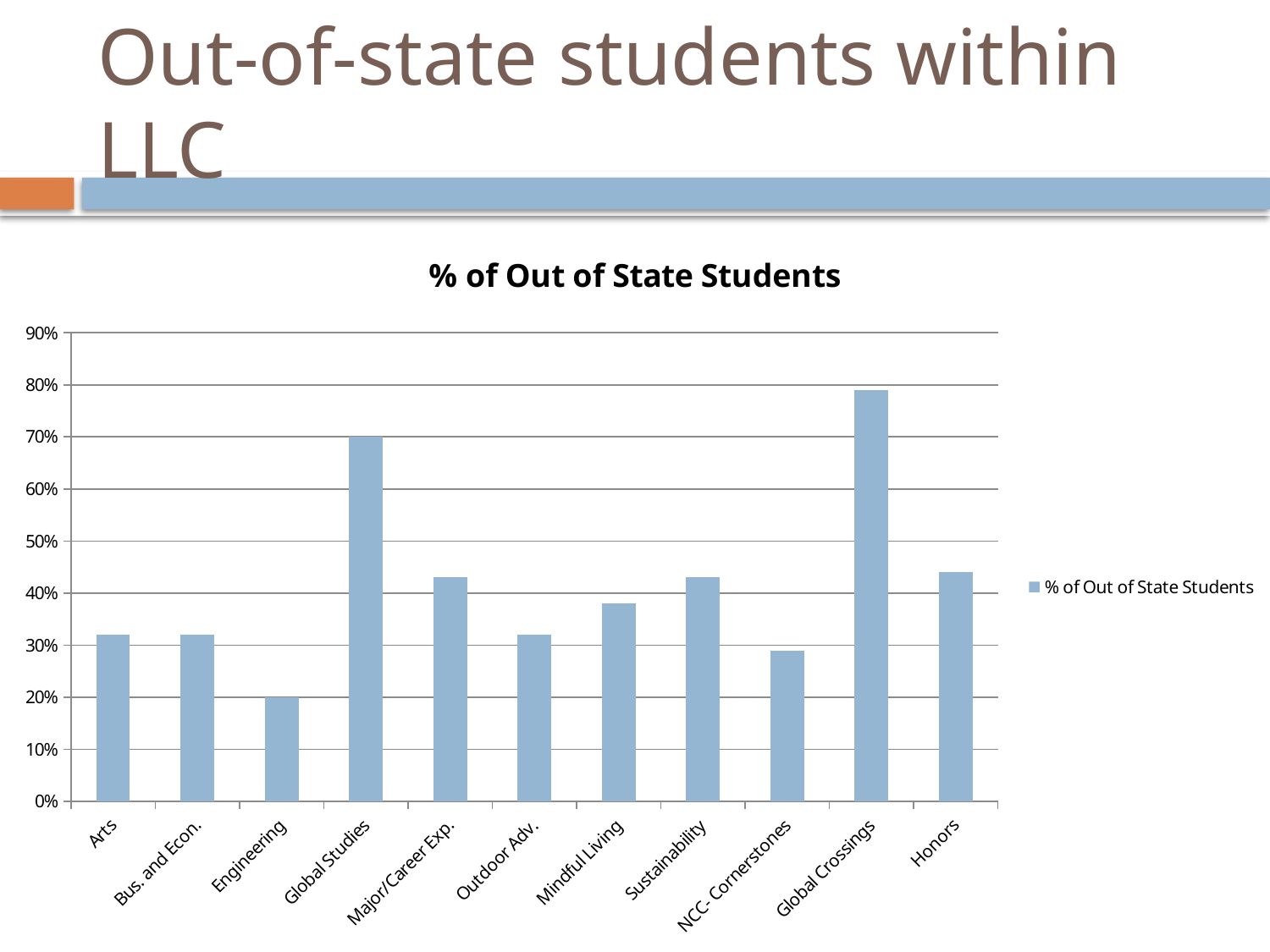
How many categories are shown on the x axis of the chart? 11 What kind of chart is shown on the slide? bar chart How many series does the legend list? 1 Is the value for Honors greater or less than 50%? less What is the % of out of state students for Engineering? 20% Which category has the lowest % of out of state students? Engineering Is the value for Mindful Living greater or less than 30%? greater What is the title of the chart? % of Out of State Students Is the value for Global Crossings greater or less than 70%? greater Which is larger, the value for Global Studies or the value for Honors? Global Studies Which category has the highest % of out of state students? Global Crossings What is the % of out of state students for Global Studies? 70%